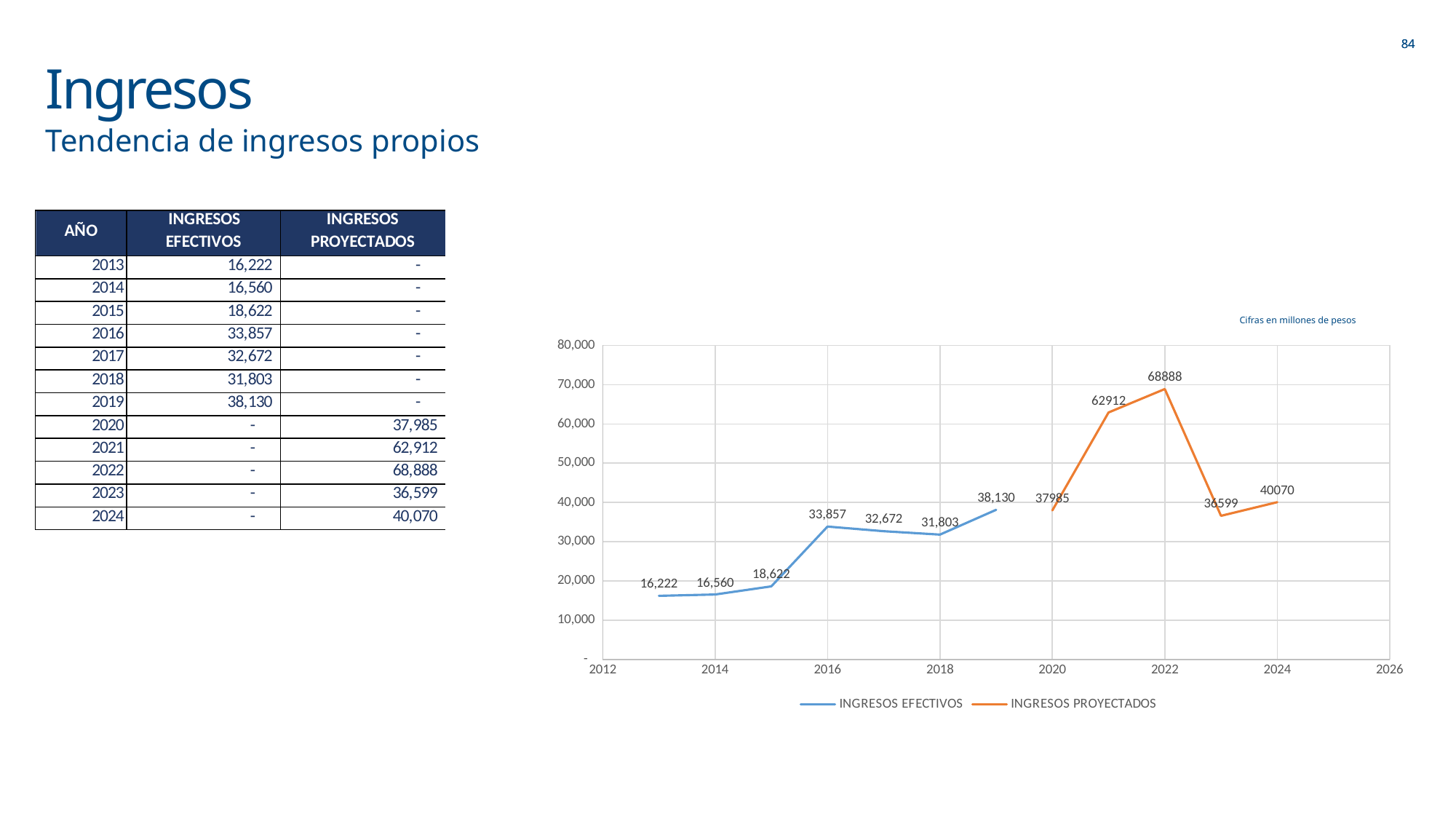
Which year has the lowest value of INGRESOS EFECTIVOS? 2013 What is the value of INGRESOS EFECTIVOS for 2013? 16,222 What is the value of INGRESOS EFECTIVOS for 2016? 33,857 How many series does the chart legend list? 2 What kind of chart is shown on the slide? line chart What is the value of INGRESOS PROYECTADOS for 2022? 68888 What is the difference between the INGRESOS EFECTIVOS values for 2019 and 2018? 6,327 Is the value of INGRESOS PROYECTADOS for 2021 greater or less than 60,000? greater What is the value of INGRESOS EFECTIVOS for 2019? 38,130 Which is larger, the INGRESOS EFECTIVOS value for 2016 or for 2017? 2016 Which year has the highest value of INGRESOS PROYECTADOS? 2022 How many data points does the INGRESOS EFECTIVOS series have? 7